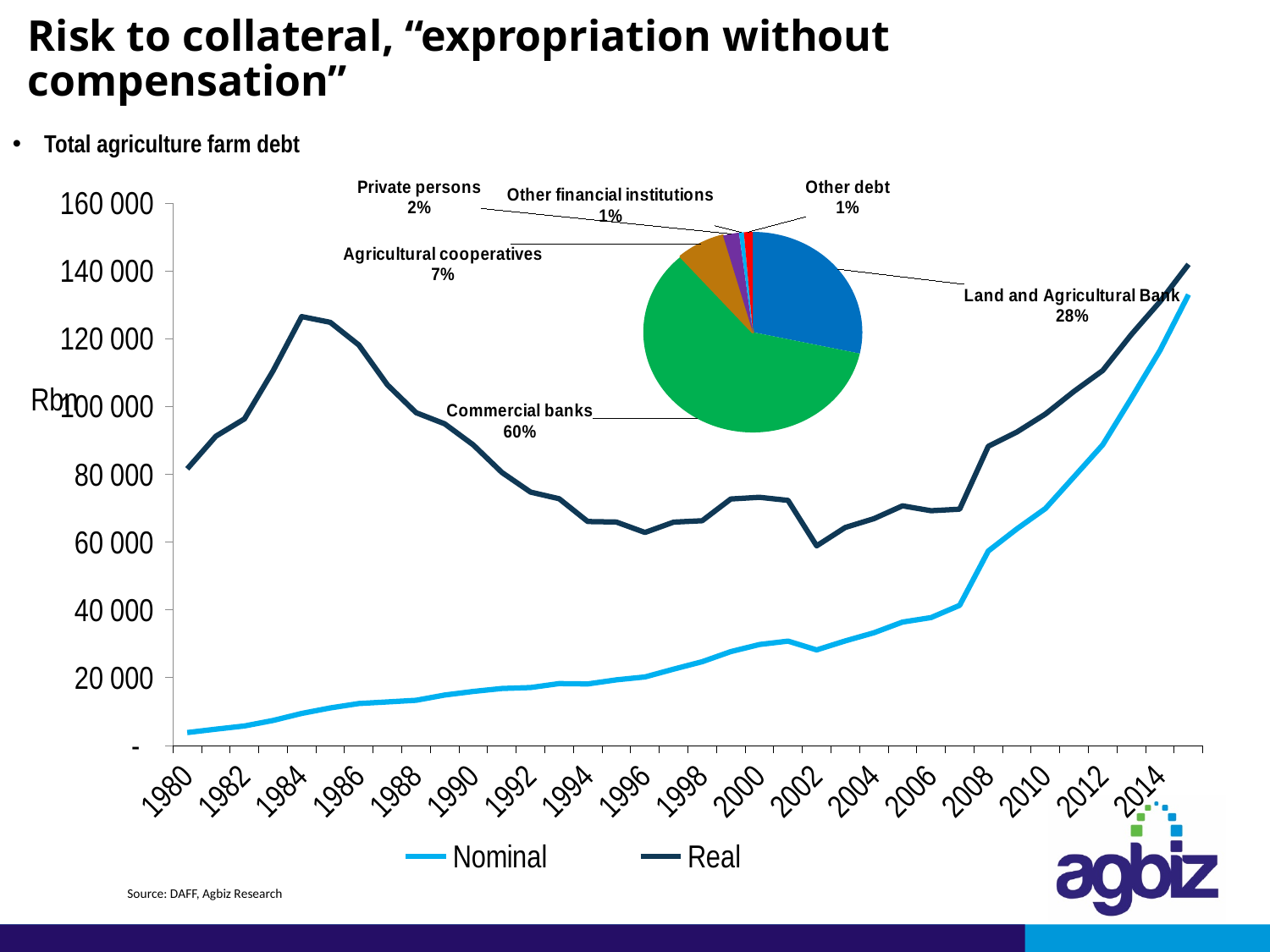
In the pie chart, what percentage of farm debt is attributed to the Land and Agricultural Bank? 28% In the pie chart, what share of total agriculture farm debt is held by commercial banks? 60% How many slices does the pie chart have? 6 In the line chart of total agriculture farm debt, how many series does the legend list? 2 In the pie chart, how many percentage points larger is the commercial banks share than the Land and Agricultural Bank share? 32 percentage points In the pie chart, which source holds the largest share of farm debt? Commercial banks In the line chart, is the Nominal farm debt value in 2010 greater or less than 80 000? less In the line chart, is the Real farm debt value in 1984 greater or less than 120 000? greater In the line chart, which series is higher in 2000, Nominal or Real? Real In the pie chart, what is the share for agricultural cooperatives? 7% What type of chart shows the Nominal and Real farm debt over time? Line chart In the line chart, does the Nominal series rise or fall from 1980 to 2014? Rise